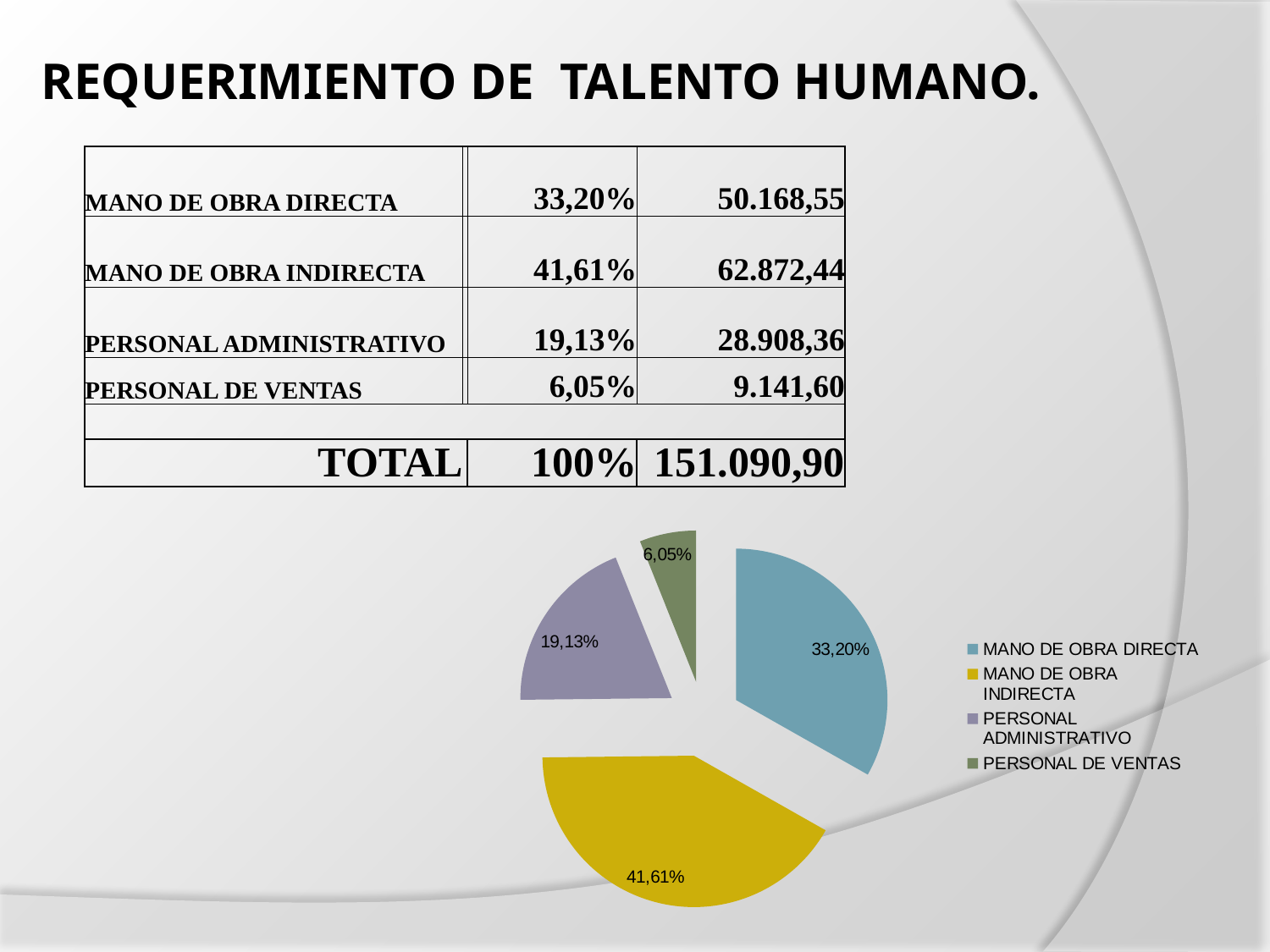
What share of the pie does PERSONAL ADMINISTRATIVO have? 19,13% What share of the pie does MANO DE OBRA DIRECTA have? 33,20% What kind of chart is shown on the slide? pie chart What share of the pie does PERSONAL DE VENTAS have? 6,05% Which is larger, the slice for MANO DE OBRA DIRECTA or the slice for PERSONAL ADMINISTRATIVO? MANO DE OBRA DIRECTA Which category has the smallest slice of the pie? PERSONAL DE VENTAS Which category has the largest slice of the pie? MANO DE OBRA INDIRECTA How many slices does the pie chart have? 4 What is the difference in percentage points between the MANO DE OBRA INDIRECTA slice and the MANO DE OBRA DIRECTA slice? 8,41 What colour is the slice for MANO DE OBRA INDIRECTA? yellow How many entries does the legend of the pie chart list? 4